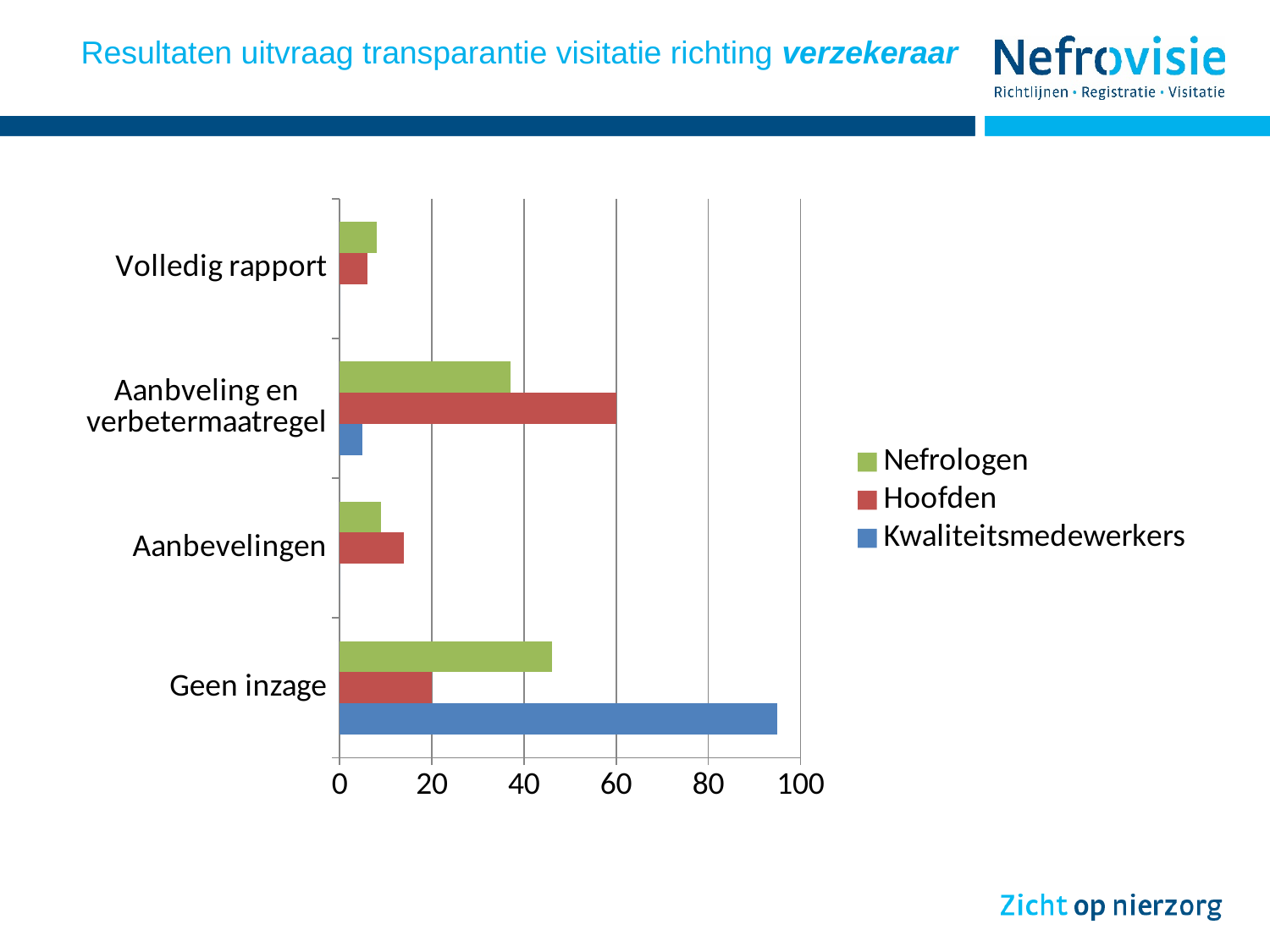
For Aanbveling en verbetermaatregel, which is larger: the Nefrologen value or the Hoofden value? Hoofden How many series does the legend list? 3 For which category is the Hoofden value highest? Aanbveling en verbetermaatregel Is the Nefrologen value for Aanbveling en verbetermaatregel greater or less than 40? less Is the Kwaliteitsmedewerkers value for Geen inzage greater or less than 80? greater Is the Hoofden value for Aanbevelingen greater or less than 20? less What kind of chart is shown on the slide? bar chart Which series has the highest value for Geen inzage? Kwaliteitsmedewerkers For which category is the Nefrologen value highest? Geen inzage How many categories are shown on the vertical axis? 4 Which series is shown in blue in the legend? Kwaliteitsmedewerkers